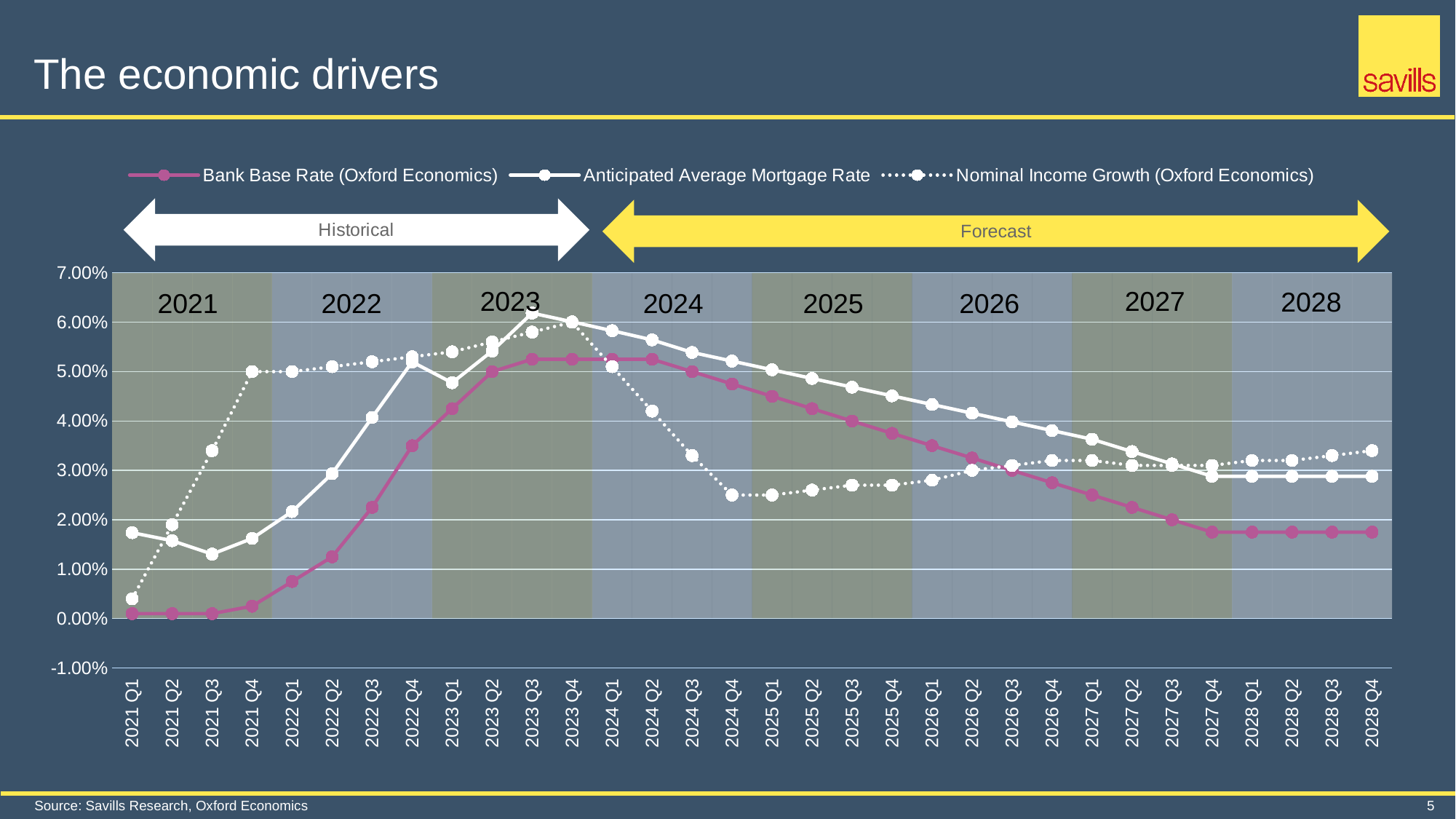
How many quarterly points are plotted along the x axis? 32 At 2025 Q1, which is larger: Anticipated Average Mortgage Rate or Nominal Income Growth (Oxford Economics)? Anticipated Average Mortgage Rate Is the Nominal Income Growth (Oxford Economics) value for 2024 Q4 greater or less than 3.00%? less Which period label does the yellow arrow above the chart carry? Forecast At 2022 Q1, which is larger: Nominal Income Growth (Oxford Economics) or Bank Base Rate (Oxford Economics)? Nominal Income Growth (Oxford Economics) How many series does the legend list? 3 Is the Bank Base Rate (Oxford Economics) value for 2028 Q4 greater or less than 2.00%? less Does the Bank Base Rate (Oxford Economics) series rise or fall from 2024 Q2 to 2027 Q4? fall Is the Anticipated Average Mortgage Rate value for 2023 Q3 greater or less than 6.00%? greater What kind of chart is shown on the slide? line chart